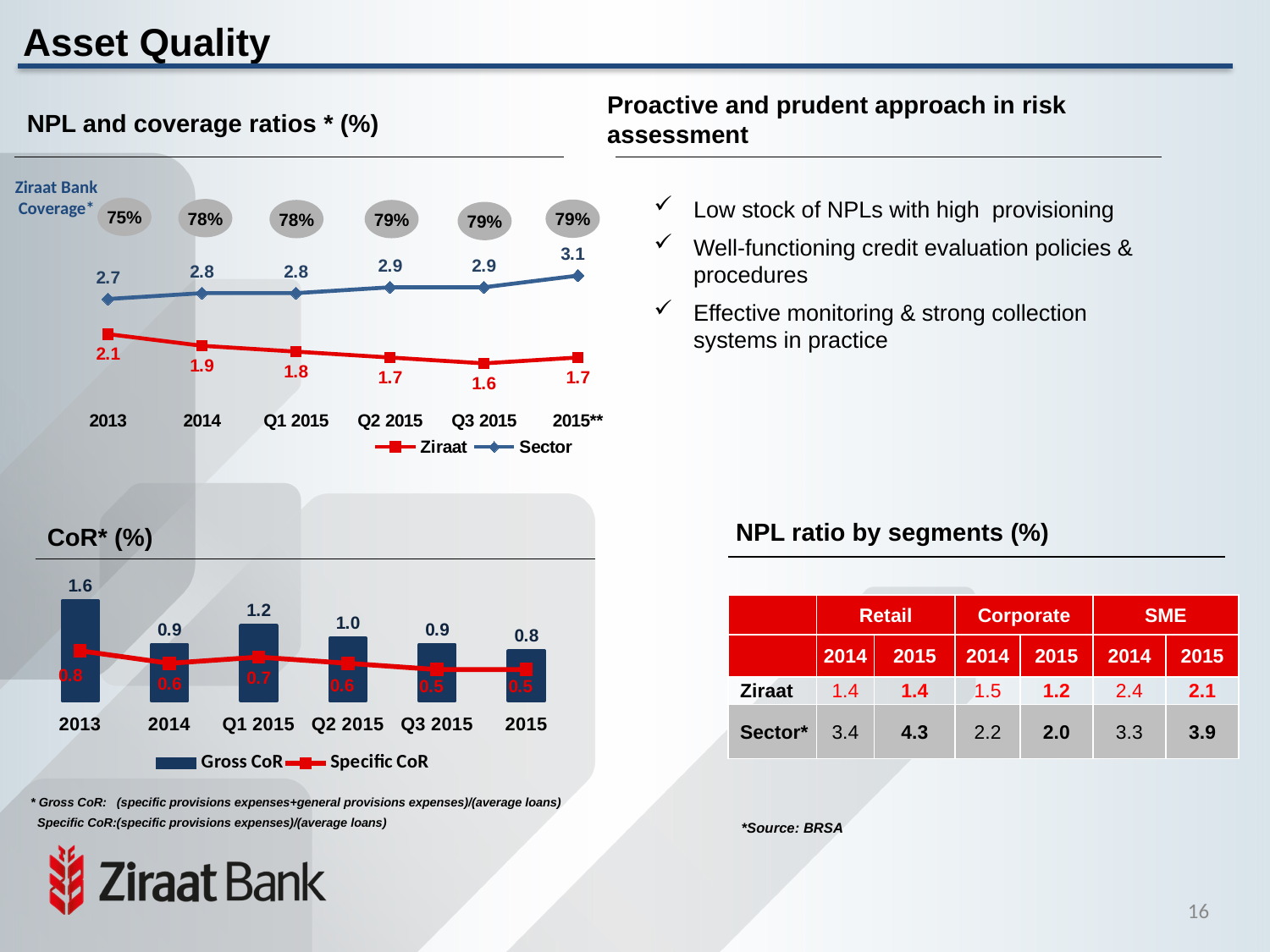
In the 'NPL and coverage ratios' chart, in which period is the Ziraat value highest? 2013 In the 'NPL and coverage ratios' chart, what is the difference between the Sector and Ziraat values in 2015**? 1.4 In the 'NPL and coverage ratios' chart, what is the Ziraat value for Q3 2015? 1.6 How many series does the legend of the 'NPL and coverage ratios' chart list? 2 In the 'CoR* (%)' chart, what is the difference between Gross CoR and Specific CoR in 2013? 0.8 In the 'NPL and coverage ratios' chart, does the Sector line rise or fall from 2013 to 2015**? rise In the 'NPL and coverage ratios' chart, what is the Ziraat Bank coverage ratio shown for 2013? 75% In the 'CoR* (%)' chart, what is the Gross CoR value for Q1 2015? 1.2 How many periods are shown on the x axis of the 'CoR* (%)' chart? 6 In the 'CoR* (%)' chart, in which period is the Gross CoR lowest? 2015 In the 'CoR* (%)' chart, what is the Specific CoR value for 2013? 0.8 In the 'NPL and coverage ratios' chart, what is the Sector value for 2015**? 3.1